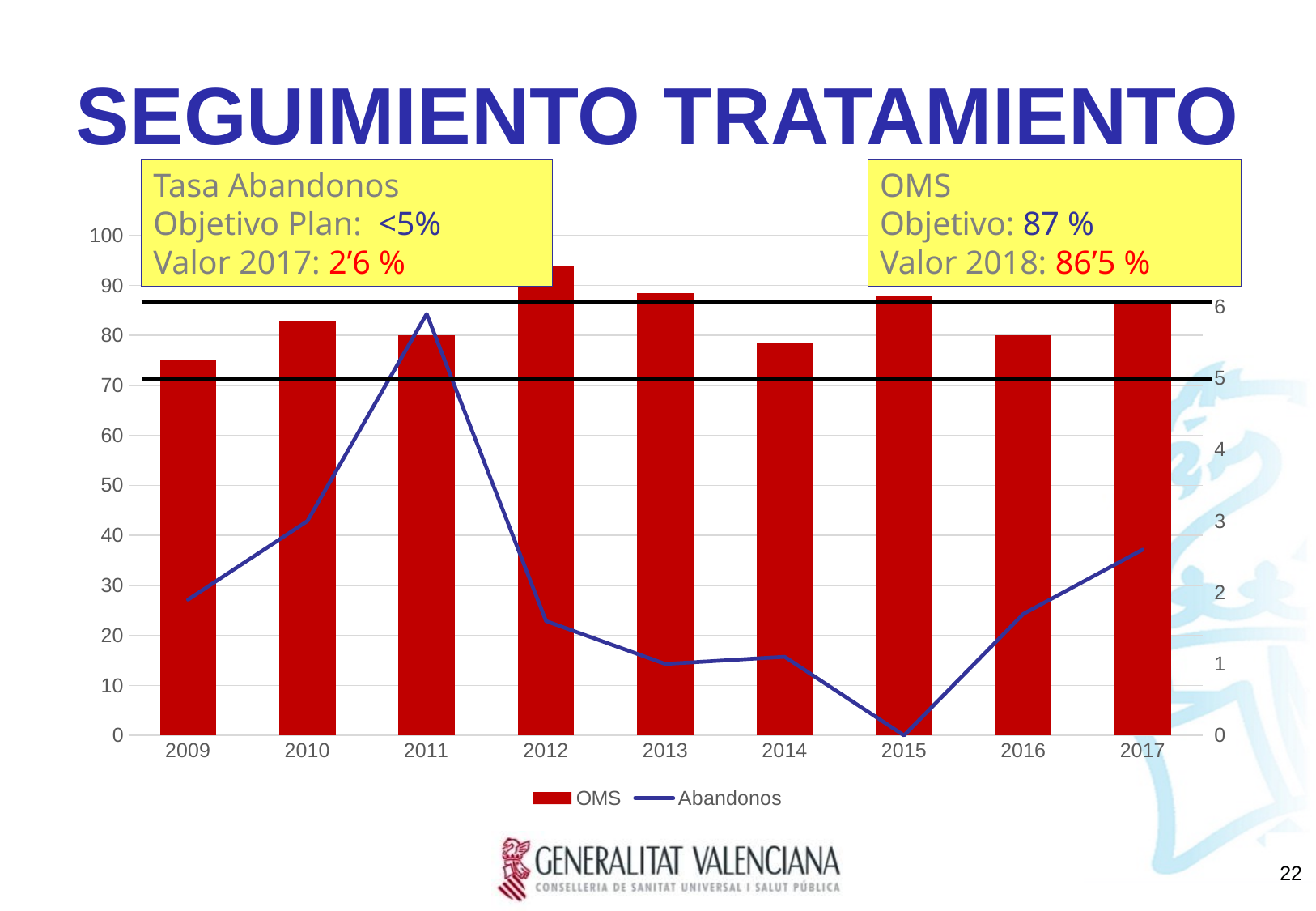
How many series does the chart legend list? 2 Is the Abandonos value for 2011 greater or less than 5 on the right axis? greater Which series is drawn as red bars in the chart? OMS In which year does the Abandonos line reach its lowest point? 2015 In which year does the Abandonos line reach its highest point? 2011 What kind of chart is shown on the slide? A combined bar and line chart In which year is the OMS bar the highest? 2012 Is the OMS value for 2012 greater or less than 90? greater Which year has the larger OMS bar, 2009 or 2012? 2012 How many years are shown on the x axis of the chart? 9 Which series is drawn as a blue line in the chart? Abandonos Is the OMS value for 2009 greater or less than 80? less